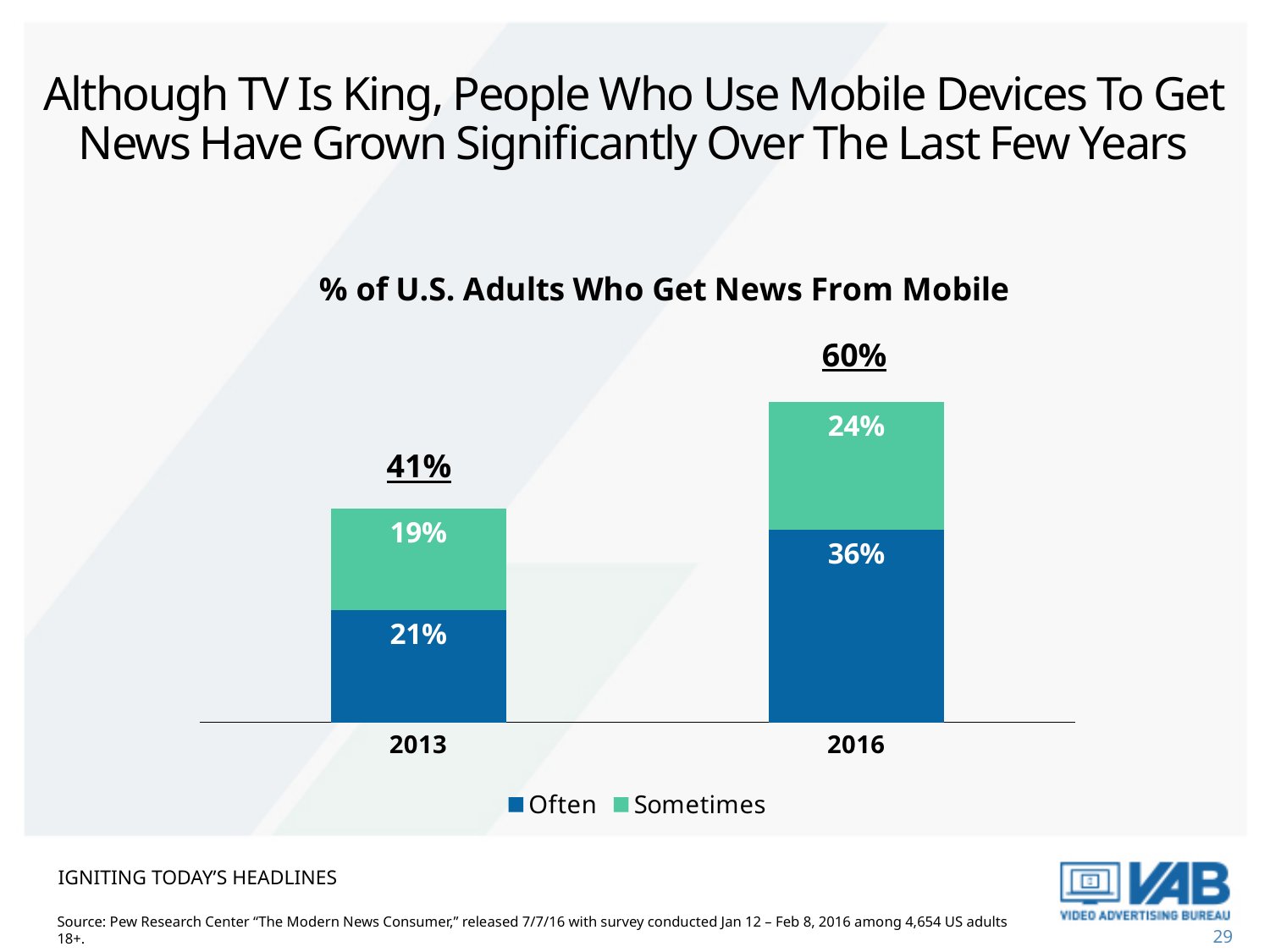
What is the value for Sometimes in 2013? 19% What is the value for Often in 2013? 21% What is the value for Sometimes in 2016? 24% What is the total of the stacked bar for 2013? 41% Which year has the higher total share of U.S. adults who get news from mobile? 2016 What is the difference between the Often values for 2016 and 2013? 15% What is the value for Often in 2016? 36% What is the total of the stacked bar for 2016? 60% What is the title of the chart? % of U.S. Adults Who Get News From Mobile How many series does the legend list? 2 What kind of chart is shown? Stacked bar chart Which is larger in 2016, Often or Sometimes? Often